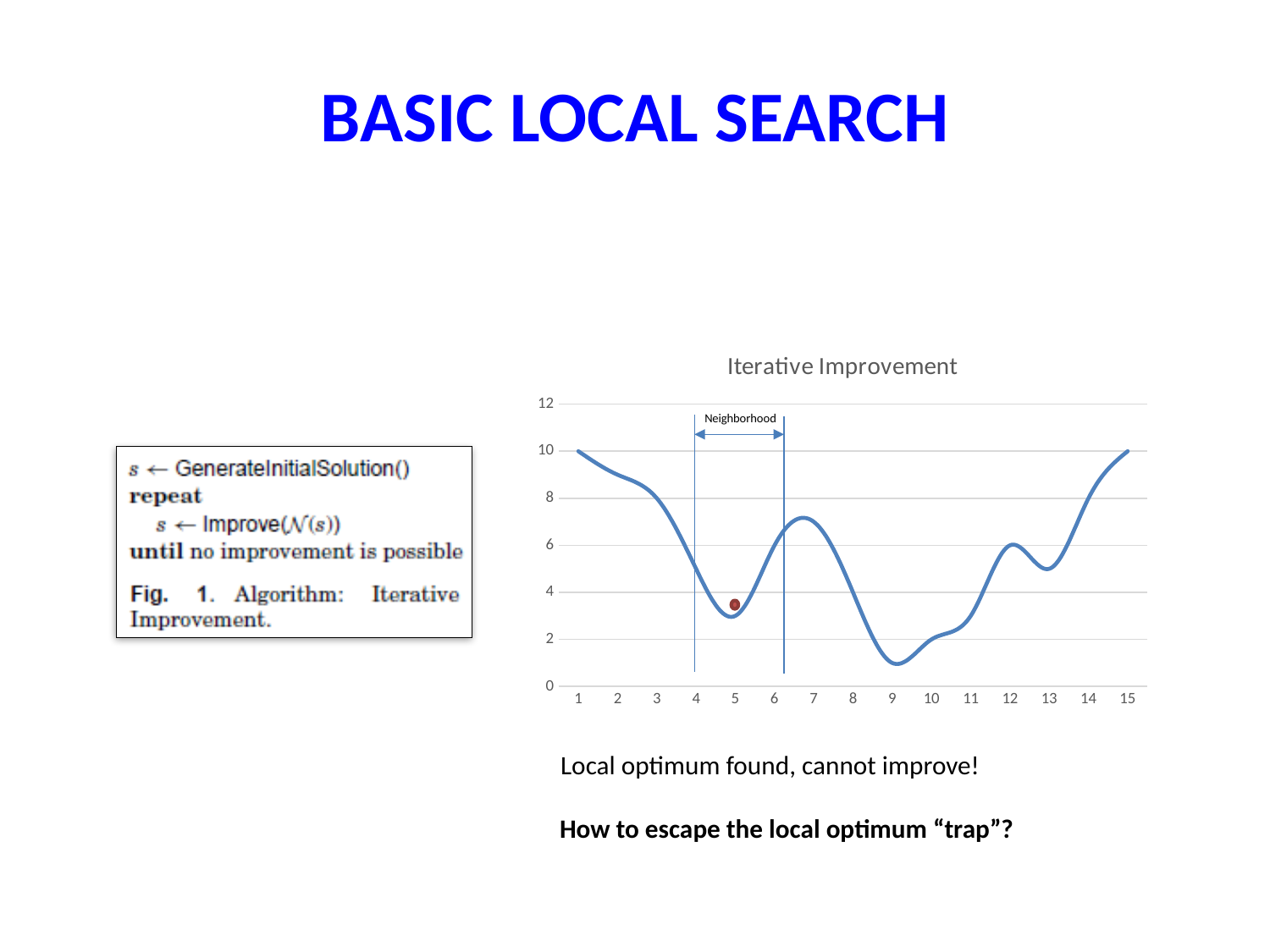
What is the title of the chart? Iterative Improvement Is the value of the line at x = 2 greater or less than 8? greater Which is larger, the value of the line at x = 7 or at x = 9? x = 7 What is the value of the line at x = 1? 10 At which x-axis value does the line reach its lowest point? 9 Is the value of the line at x = 5 greater or less than 4? less Is the value of the line at x = 7 greater or less than 6? greater What label is written between the two vertical lines on the chart? Neighborhood How many points are labelled along the x axis of the chart? 15 What kind of chart is shown on the slide? line chart